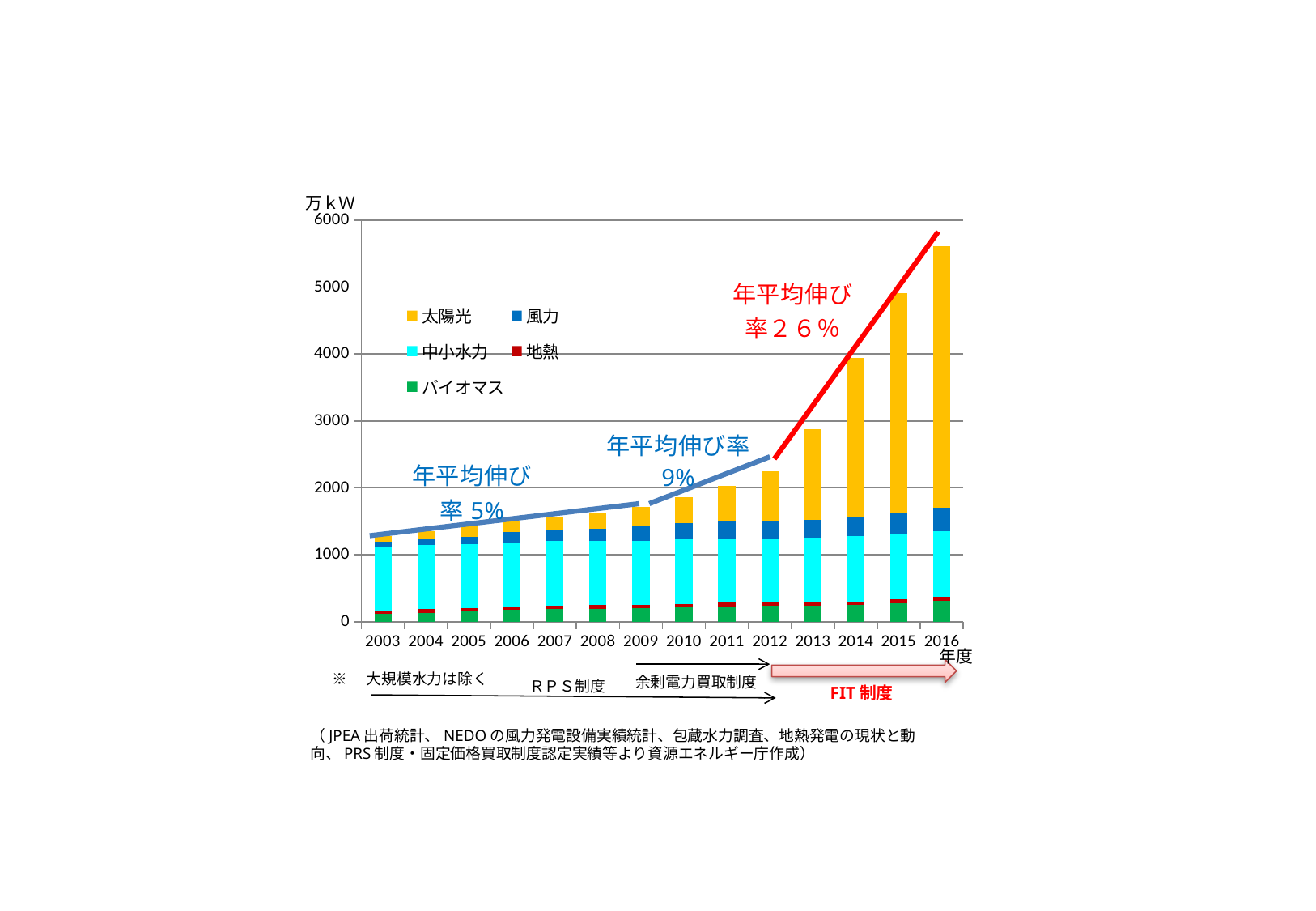
How many series does the legend list? 5 Is the total for 2003 greater or less than 2000? less Which year has the shortest stacked bar? 2003 What unit is shown on the y axis? 万kW Do the total bar heights rise or fall from 2003 to 2016? rise Is the total for 2012 greater or less than 2000? greater Is the total for 2016 greater or less than 5000? greater Which year has the tallest stacked bar? 2016 What kind of chart is shown on the slide? stacked bar chart How many years (categories) are plotted along the x axis? 14 What average annual growth rate is annotated in red for the FIT period? 26% Which is larger, the total bar for 2015 or the total bar for 2016? 2016